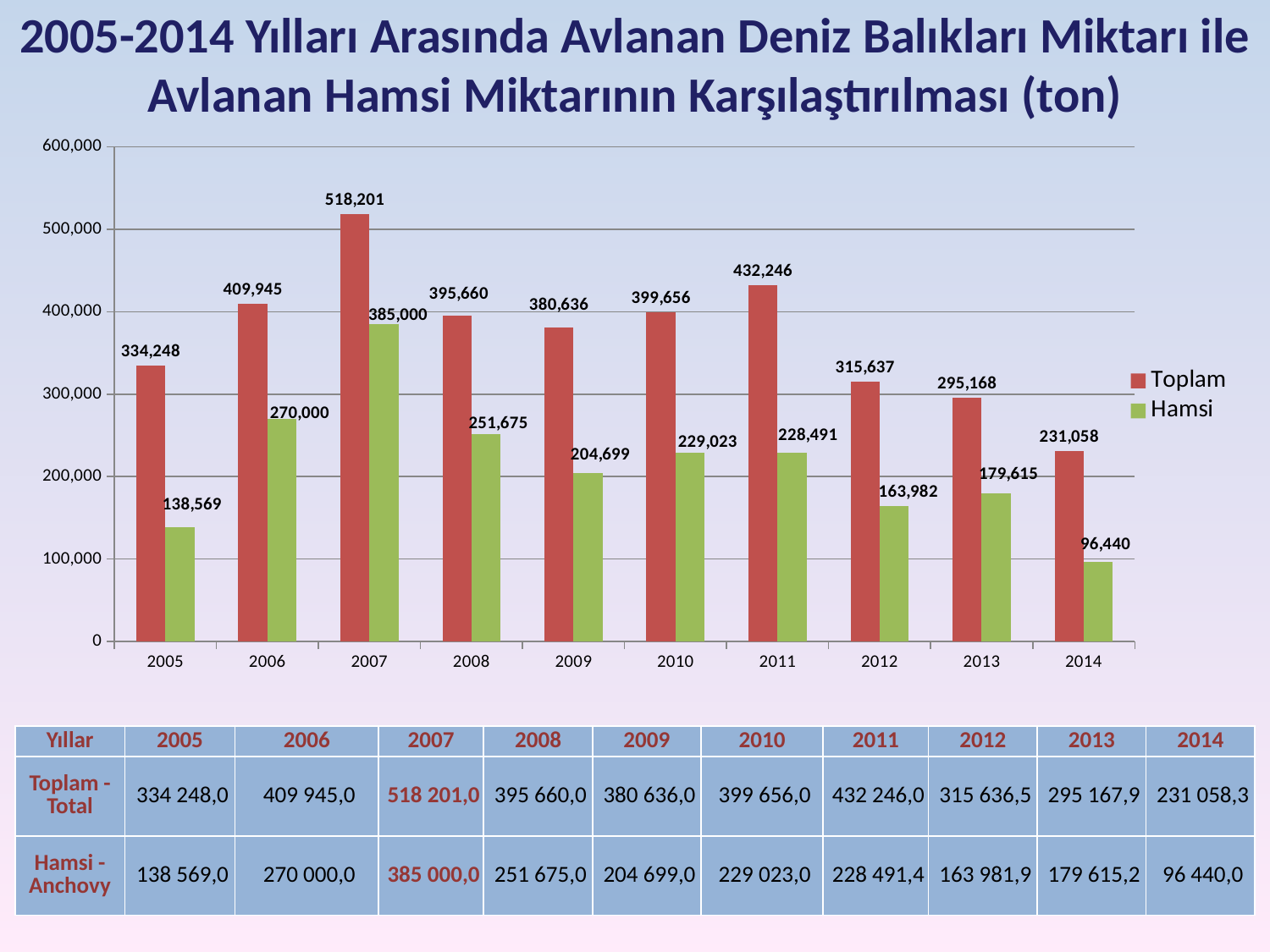
What is the difference between the Toplam and Hamsi values in 2007? 133,201 In which year is the Toplam value highest? 2007 What is the Hamsi value for 2014? 96,440 Does the Toplam value rise or fall from 2011 to 2014? fall Which is larger, the Toplam value for 2008 or for 2009? 2008 What kind of chart is shown on the slide? bar chart What is the Hamsi value for 2006? 270,000 How many years are shown on the x axis of the chart? 10 In which year is the Hamsi value lowest? 2014 Is the Toplam value for 2012 greater or less than 300,000? greater How many series does the legend list? 2 What is the Toplam value for 2007? 518,201